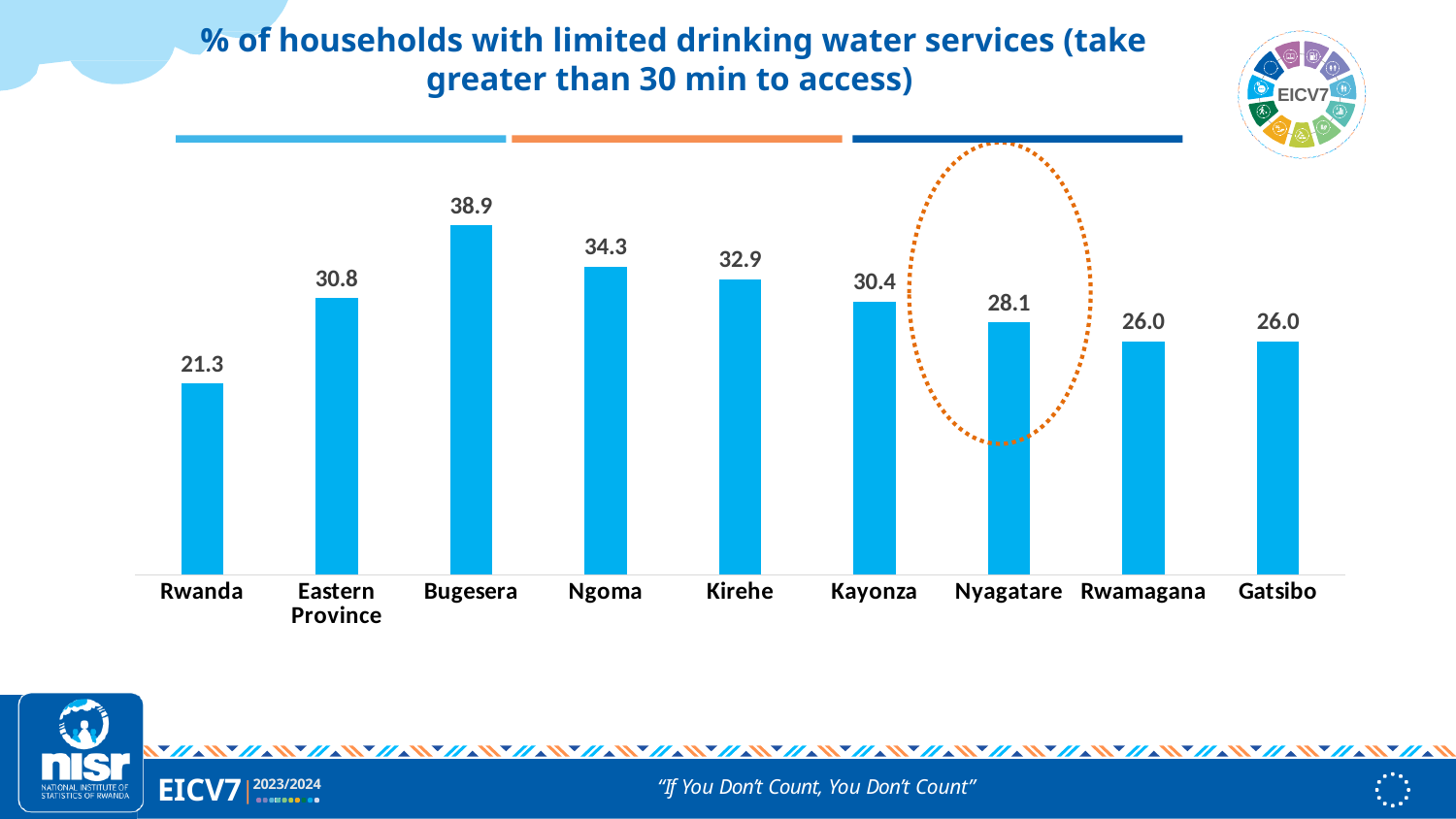
What is the title of the chart? % of households with limited drinking water services (take greater than 30 min to access) What kind of chart is shown on the slide? Bar chart Which category has the lowest value? Rwanda What is the value for Bugesera? 38.9 Which is larger, the value for Kayonza or the value for Nyagatare? Kayonza What is the difference between the values for Bugesera and Rwanda? 17.6 What is the value for Nyagatare? 28.1 What is the value for Eastern Province? 30.8 What is the difference between the values for Ngoma and Kirehe? 1.4 How many categories are shown on the x axis? 9 Which category has the highest value? Bugesera What is the value for Rwanda? 21.3